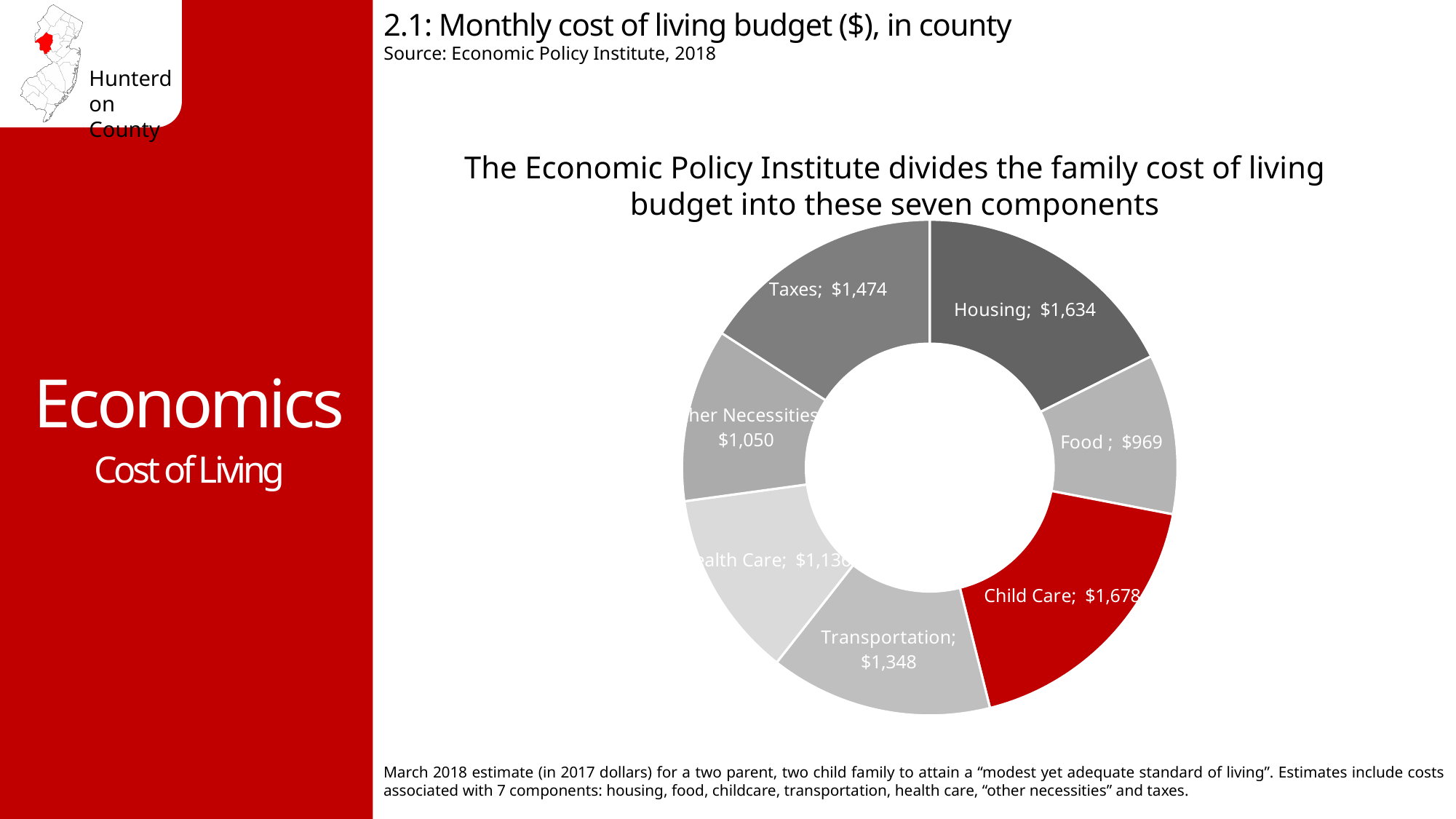
How many components are shown in the chart? 7 What is the monthly cost for Food? $969 What kind of chart is used to show the monthly cost of living budget? Pie chart (doughnut) What is the difference between the Taxes and Transportation monthly costs? $126 What is the monthly cost for Housing? $1,634 Which component has the smallest monthly cost? Food What is the difference between the Child Care and Housing monthly costs? $44 Which is larger, the monthly cost for Taxes or for Transportation? Taxes Which component has the largest monthly cost? Child Care What is the monthly cost for Child Care? $1,678 What is the monthly cost for Taxes? $1,474 What is the monthly cost for Transportation? $1,348